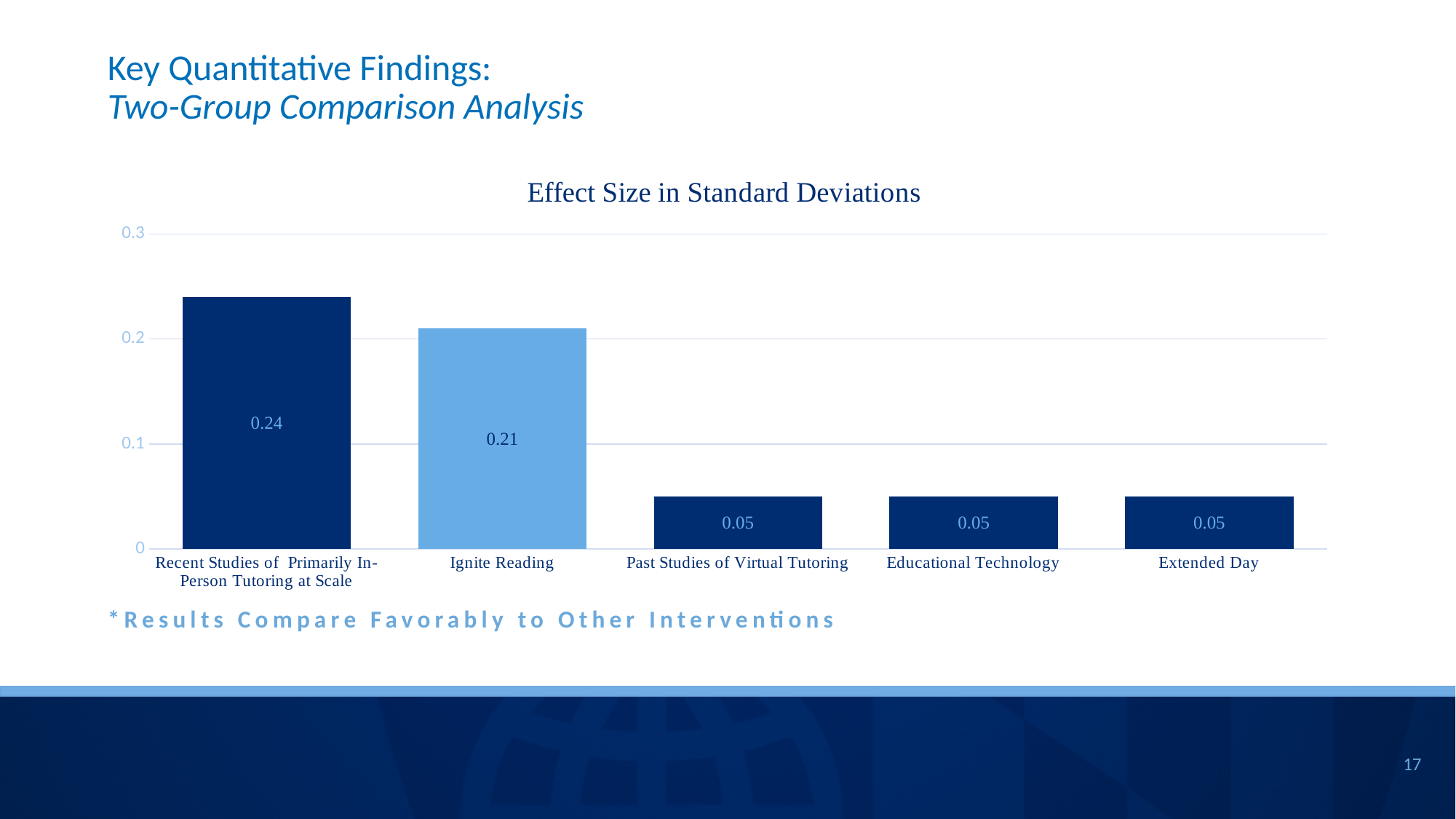
What is the effect size for Past Studies of Virtual Tutoring? 0.05 What is the difference in effect size between Ignite Reading and Educational Technology? 0.16 What is the title of the chart? Effect Size in Standard Deviations What is the difference in effect size between Recent Studies of Primarily In-Person Tutoring at Scale and Ignite Reading? 0.03 Which has a larger effect size, Ignite Reading or Past Studies of Virtual Tutoring? Ignite Reading What is the effect size for Ignite Reading? 0.21 Which category has the highest effect size? Recent Studies of Primarily In-Person Tutoring at Scale What is the effect size for Extended Day? 0.05 How many categories are shown in the chart? 5 Is the effect size for Ignite Reading greater or less than 0.1? greater What kind of chart is shown on the slide? Bar chart What is the effect size for Recent Studies of Primarily In-Person Tutoring at Scale? 0.24